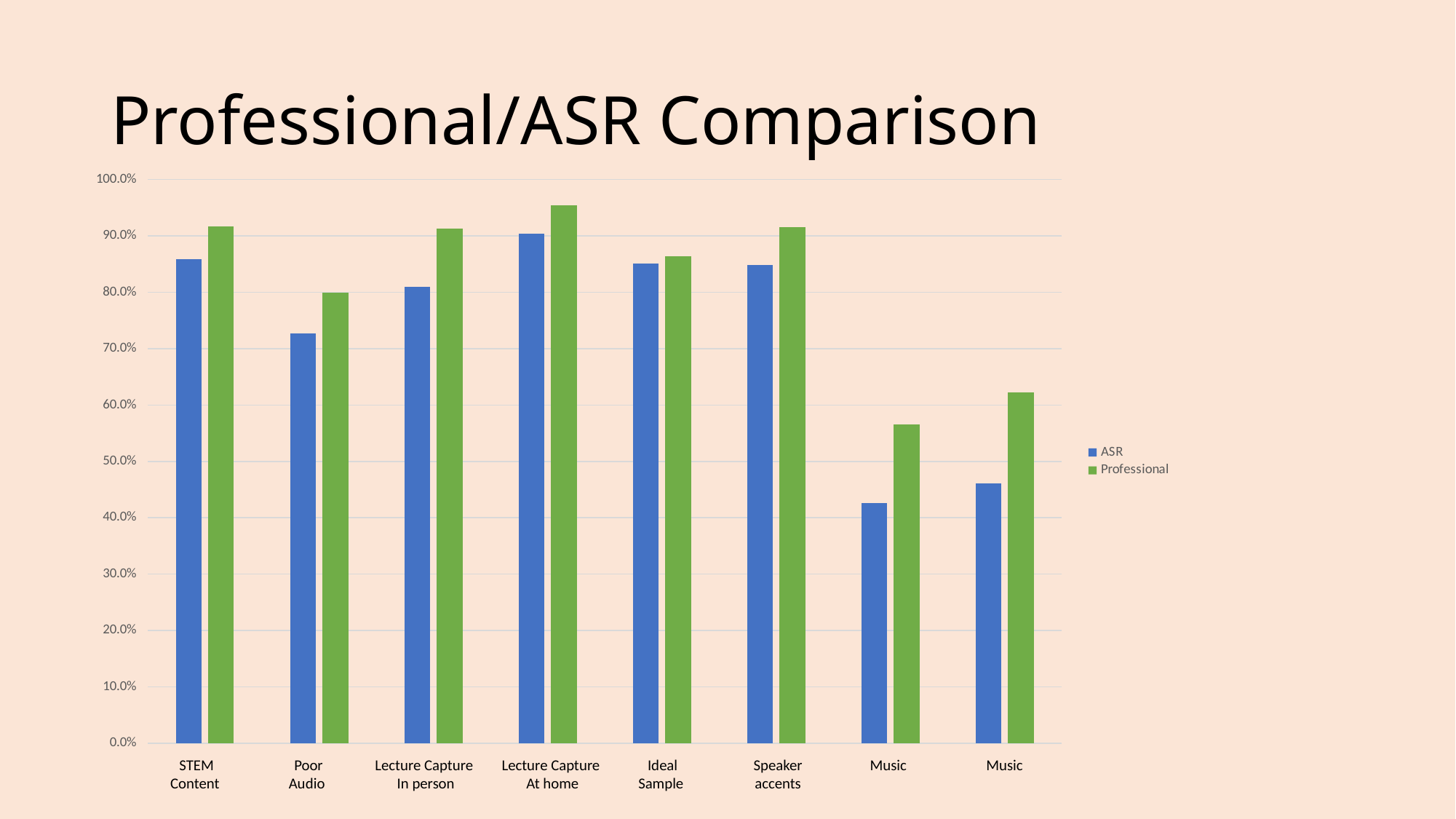
For Lecture Capture In person, which is larger, the ASR value or the Professional value? Professional What colour are the ASR bars? blue For Poor Audio, which is larger, the ASR value or the Professional value? Professional Is the ASR value for Poor Audio greater or less than 70.0%? greater Which category has the highest ASR value? Lecture Capture At home How many series does the legend list? 2 Is the ASR value for Lecture Capture In person greater or less than 90.0%? less Is the Professional value for Lecture Capture At home greater or less than 90.0%? greater Which category has the highest Professional value? Lecture Capture At home What kind of chart is shown on the slide? bar chart How many categories are shown on the x axis? 8